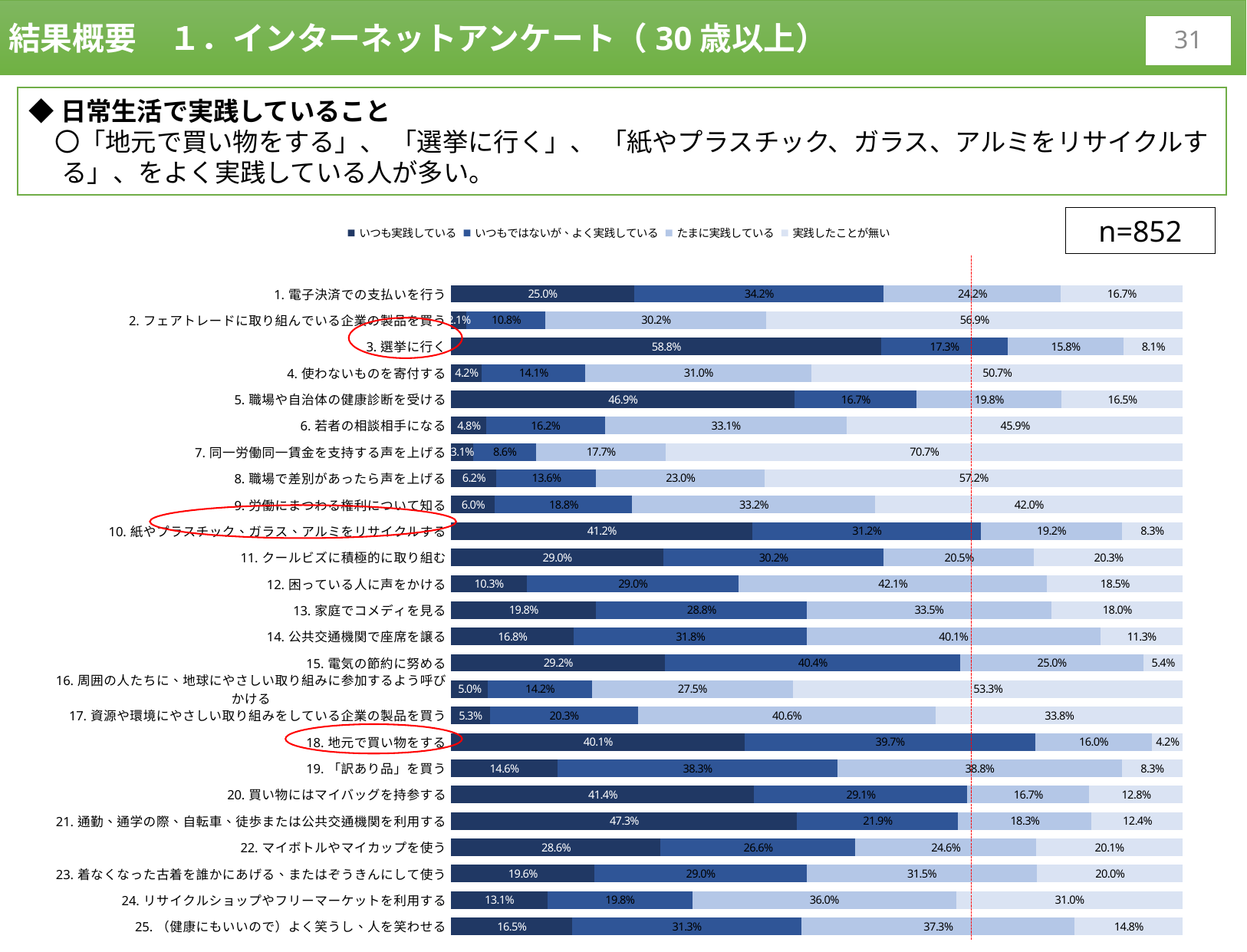
What is the value of いつもではないが、よく実践している for 18. 地元で買い物をする? 39.7% Which category has the lowest value for いつも実践している? 2. フェアトレードに取り組んでいる企業の製品を買う Which category has the highest value for 実践したことが無い? 7. 同一労働同一賃金を支持する声を上げる Which category has the highest value for いつも実践している? 3. 選挙に行く Which has a larger いつも実践している value: 1. 電子決済での支払いを行う or 15. 電気の節約に努める? 15. 電気の節約に努める What is the difference between the いつも実践している values for 3. 選挙に行く and 18. 地元で買い物をする? 18.7 percentage points What is the value of たまに実践している for 1. 電子決済での支払いを行う? 24.2% How many categories (items) are plotted in the chart? 25 What is the value of 実践したことが無い for 7. 同一労働同一賃金を支持する声を上げる? 70.7% How many series does the legend list? 4 What type of chart is shown on the slide? Stacked bar chart What is the value of いつも実践している for 3. 選挙に行く? 58.8%